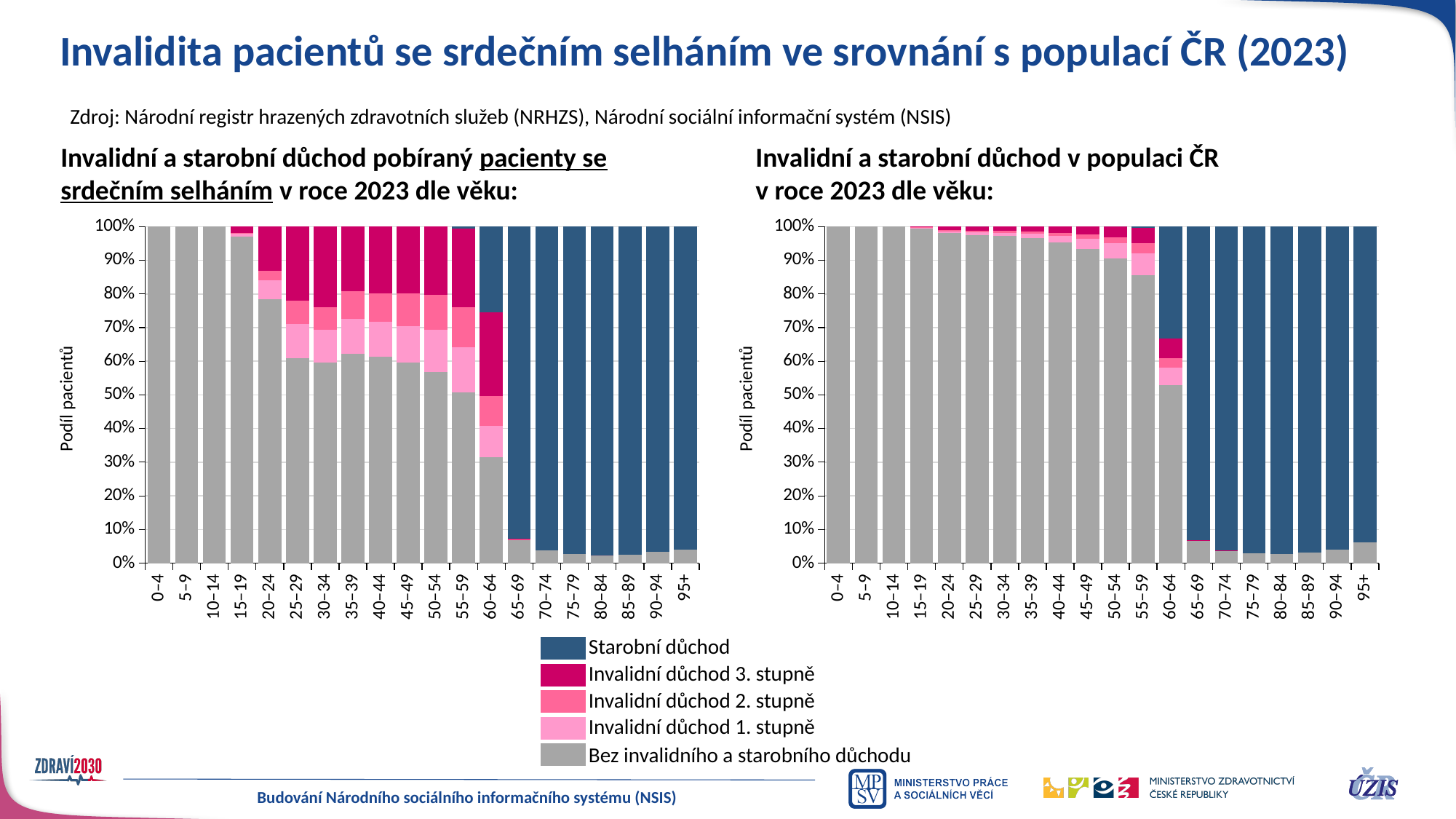
In the left chart (patients with heart failure), is the 'Starobní důchod' share for the 65–69 age group greater or less than 90%? greater For the 60–64 age group, which chart shows the larger 'Bez invalidního a starobního důchodu' share: the left chart (patients with heart failure) or the right chart (population of ČR)? The right chart (population of ČR) In the right chart (population of ČR), is the 'Bez invalidního a starobního důchodu' share for the 60–64 age group greater or less than 50%? greater What kind of chart is the left chart, 'Invalidní a starobní důchod pobíraný pacienty se srdečním selháním v roce 2023 dle věku'? Stacked bar chart In the left chart (patients with heart failure), is the 'Bez invalidního a starobního důchodu' share for the 60–64 age group greater or less than 40%? less Which legend entry is shown in dark blue? Starobní důchod How many age categories are shown on the x axis of the right chart, 'Invalidní a starobní důchod v populaci ČR v roce 2023 dle věku'? 20 How many series does the shared legend list for the two charts? 5 In the left chart (patients with heart failure), which age group has the larger 'Bez invalidního a starobního důchodu' share: 20–24 or 60–64? 20–24 In the left chart (patients with heart failure), does the 'Bez invalidního a starobního důchodu' share rise or fall from the 0–4 age group to the 60–64 age group? Fall